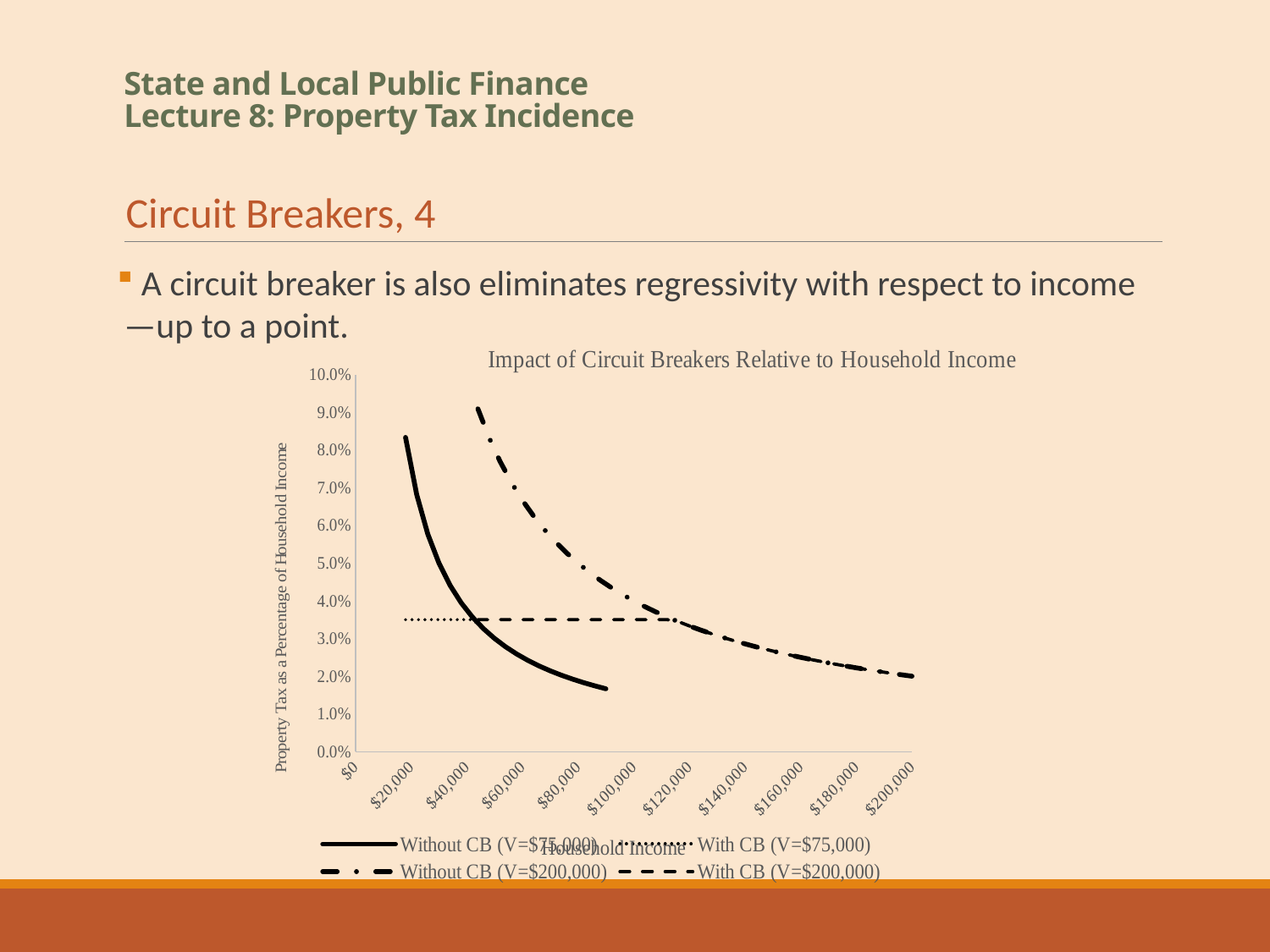
Is the value of the Without CB (V=$200,000) line at $100,000 household income greater or less than 3.0%? greater At $60,000 household income, which line is higher: Without CB (V=$200,000) or Without CB (V=$75,000)? Without CB (V=$200,000) What is the title of the chart? Impact of Circuit Breakers Relative to Household Income Is the value of the Without CB (V=$75,000) line at $80,000 household income greater or less than 3.0%? less Does the Without CB (V=$75,000) line rise or fall as household income increases? fall Does the Without CB (V=$200,000) line rise or fall as household income increases? fall How many series does the chart's legend list? 4 Is the value of the With CB (V=$200,000) line at $100,000 household income greater or less than 4.0%? less What kind of chart is shown on the slide? line chart What is the label of the vertical axis of the chart? Property Tax as a Percentage of Household Income How many tick labels are shown on the horizontal axis of the chart? 11